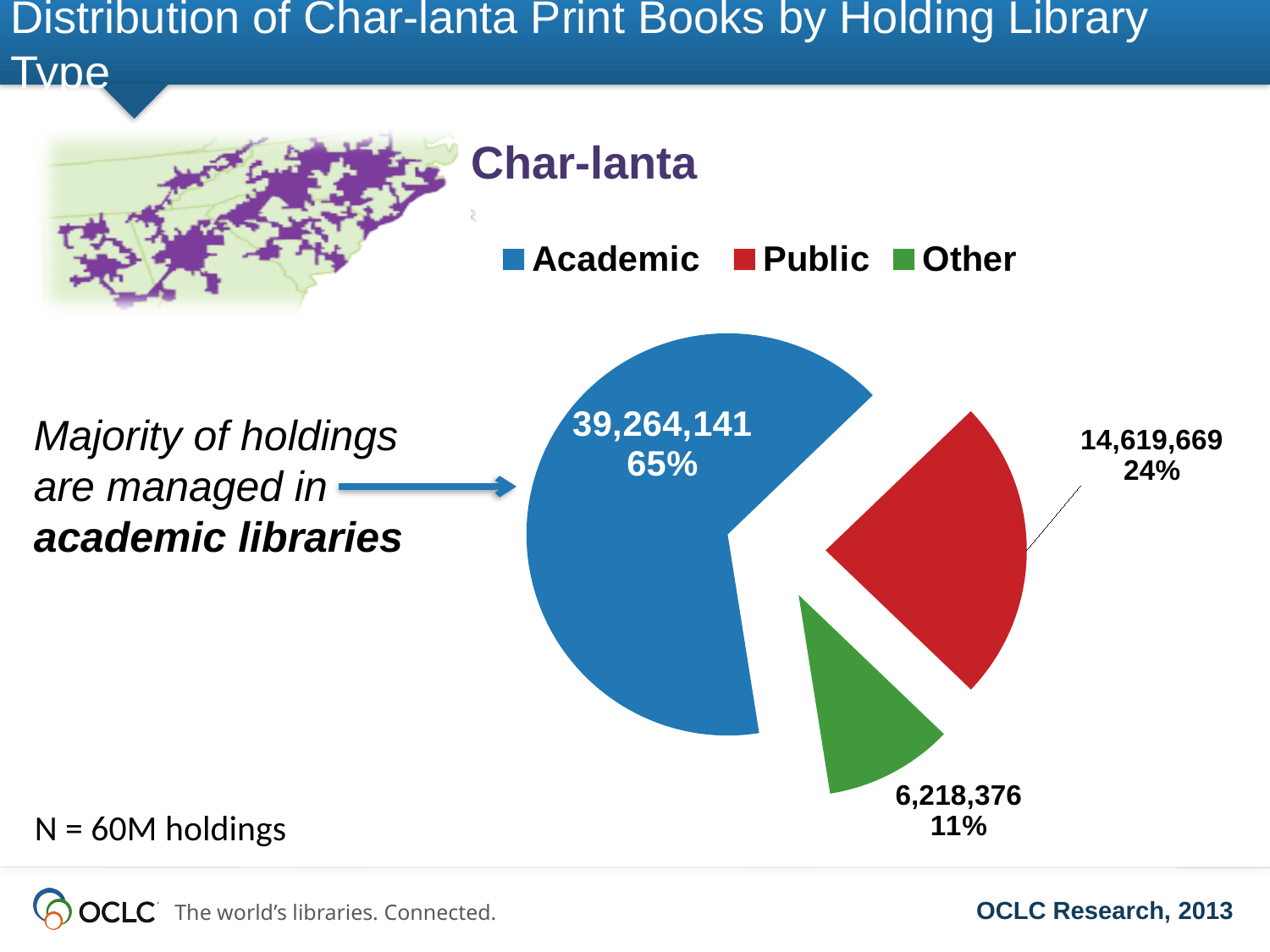
Which has more holdings, Public or Other libraries? Public Which library type holds the largest share of holdings? Academic What share of the pie does the Public slice represent? 24% What kind of chart is shown on the slide? pie chart What is the title of the pie chart? Char-lanta What is the difference in holdings between Academic and Public libraries? 24,644,472 What is the number of holdings for Other libraries? 6,218,376 Which library type holds the smallest share of holdings? Other What is the number of holdings for Public libraries? 14,619,669 What share of the pie does the Other slice represent? 11% What is the number of holdings for Academic libraries? 39,264,141 How many slices does the pie chart have? 3